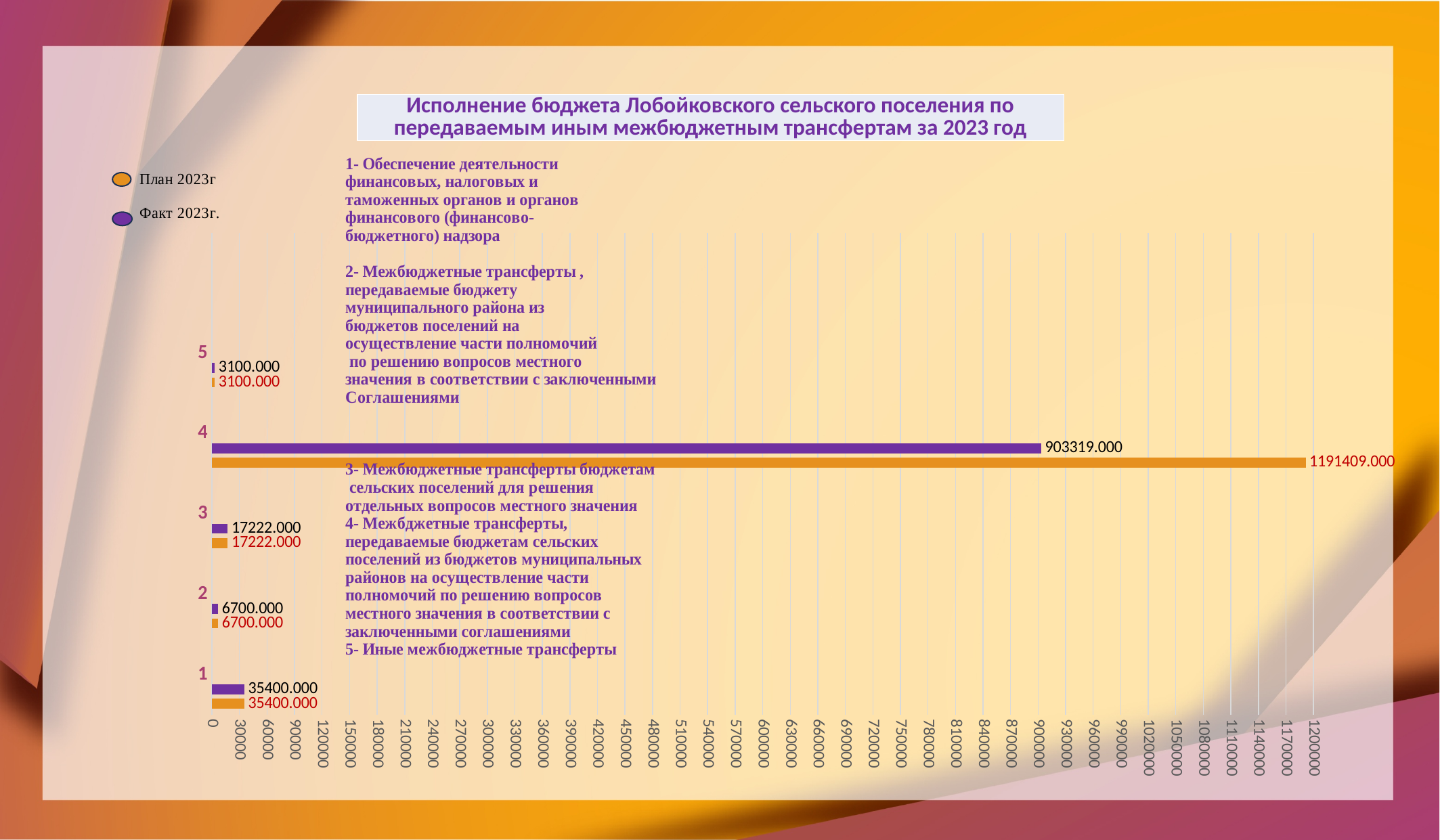
Which category has the highest План 2023г value? 4 What kind of chart is shown on the slide? bar chart What is the Факт 2023г. value for category 4? 903319.000 What is the План 2023г value for category 5? 3100.000 Which category has the lowest Факт 2023г. value? 5 How many categories are shown on the chart? 5 For category 4, which is larger: the План 2023г value or the Факт 2023г. value? План 2023г What is the План 2023г value for category 3? 17222.000 What is the difference between the План 2023г and Факт 2023г. values for category 4? 288090.000 How many series does the legend list? 2 What is the План 2023г value for category 4? 1191409.000 What is the Факт 2023г. value for category 1? 35400.000